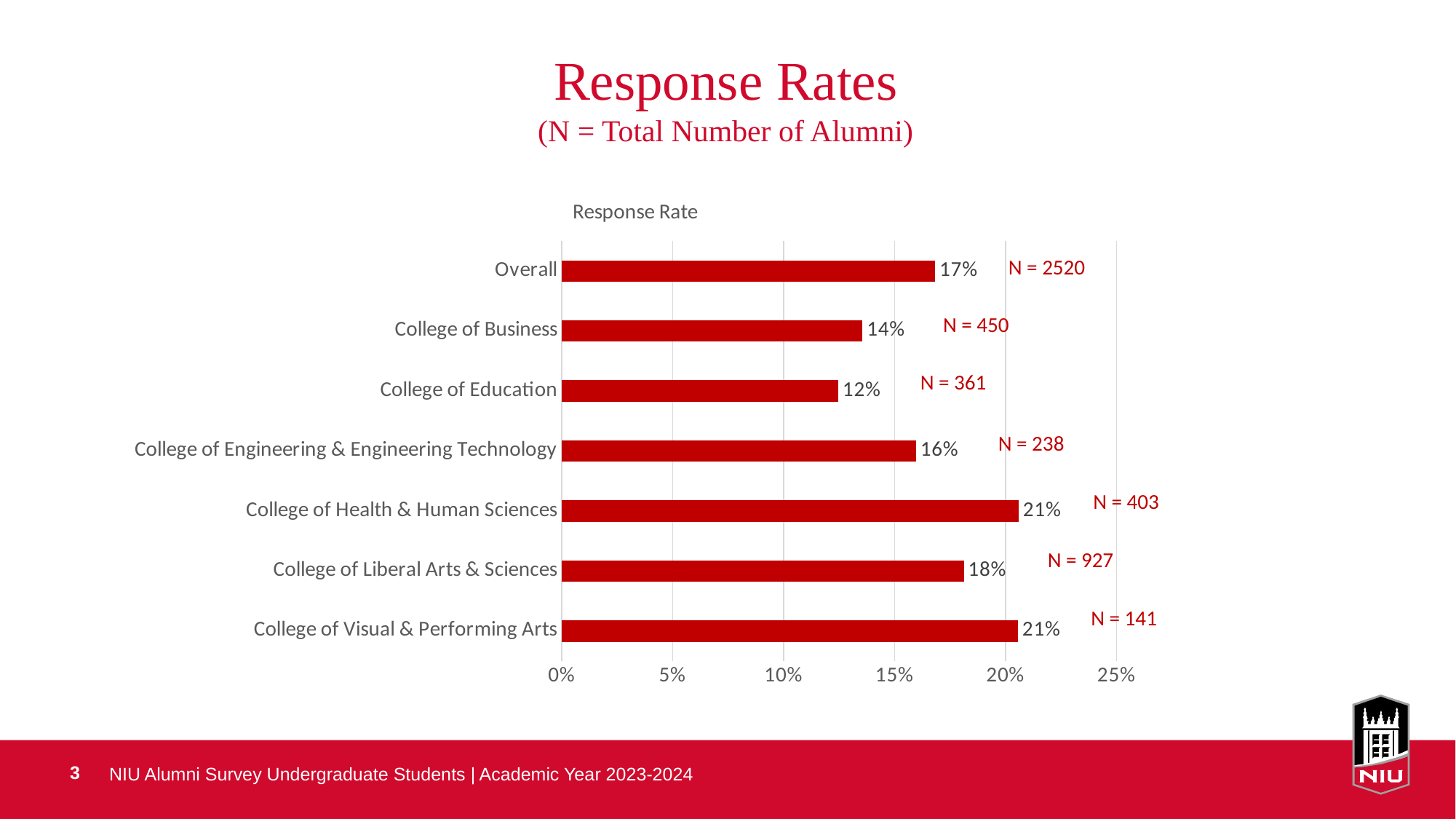
What is the difference between the Overall response rate and the College of Education response rate? 5% What is the N value shown next to the College of Liberal Arts & Sciences bar? N = 927 How many categories are plotted in the chart? 7 What kind of chart is shown on the slide? Bar chart Which has a higher response rate, the College of Business or the College of Liberal Arts & Sciences? College of Liberal Arts & Sciences Which category has the lowest response rate? College of Education Is the response rate for the College of Visual & Performing Arts greater or less than 20%? greater What is the response rate for the College of Liberal Arts & Sciences? 18% What is the Overall response rate shown in the chart? 17% What is the response rate for the College of Engineering & Engineering Technology? 16% What is the difference between the response rates of the College of Health & Human Sciences and the College of Business? 7% What is the response rate for the College of Education? 12%